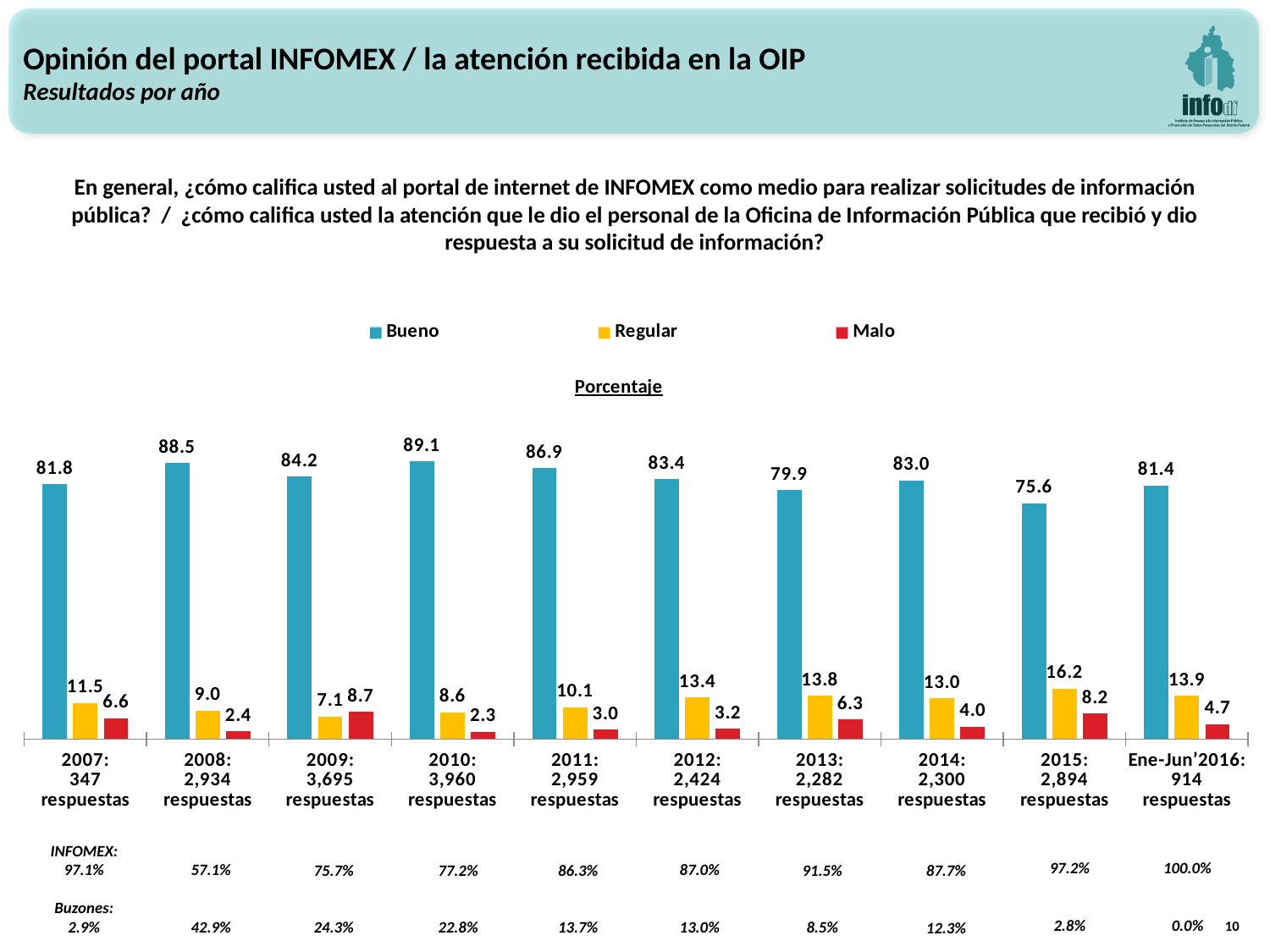
Which colour represents the Malo series? Red What is the Regular value for 2015? 16.2 What is the Bueno value for 2010? 89.1 Which year has the lowest Bueno value? 2015 Which year has the lowest Malo value? 2010 What is the difference between the Bueno values for 2008 and 2015? 12.9 What is the Malo value for 2009? 8.7 How many series does the legend list? 3 Which year has the highest Bueno value? 2010 What kind of chart is shown on the slide? Bar chart How many year categories are shown on the x axis? 10 Is the Regular value for 2012 larger than the Regular value for 2011? Yes